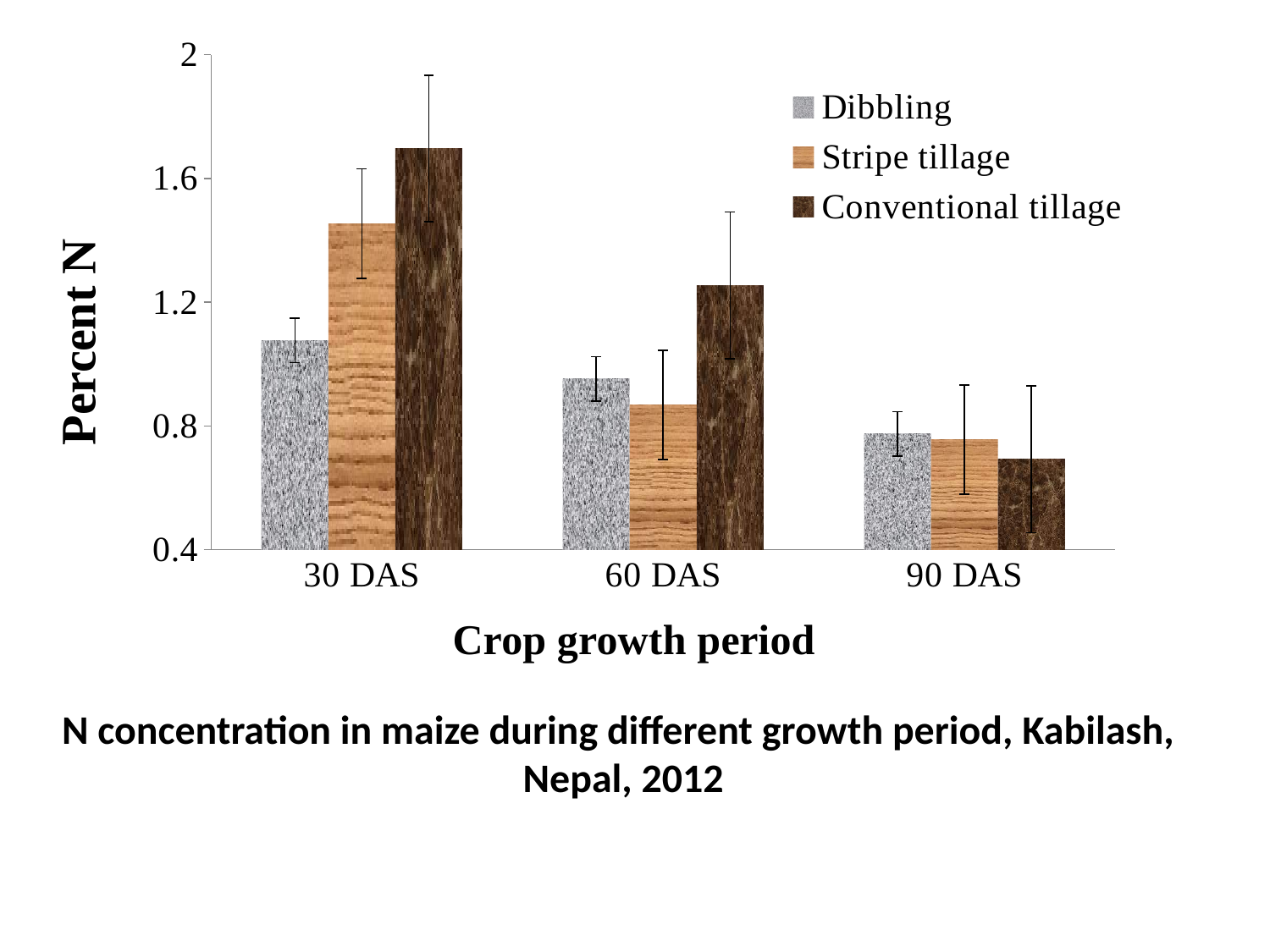
Which tillage method has the lowest Percent N at 30 DAS? Dibbling How many series does the legend list? 3 Which tillage method has the highest Percent N at 60 DAS? Conventional tillage Which tillage method has the highest Percent N at 30 DAS? Conventional tillage What is the title of the y axis? Percent N Is the value for Stripe tillage at 60 DAS greater or less than 1.2? less Is the value for Conventional tillage at 90 DAS greater or less than 0.8? less How many crop growth periods are shown on the x axis? 3 Is the value for Conventional tillage at 30 DAS greater or less than 1.6? greater Does the Percent N for Conventional tillage rise or fall from 30 DAS to 90 DAS? fall What kind of chart is shown on the slide? bar chart At 30 DAS, which is larger: Dibbling or Stripe tillage? Stripe tillage